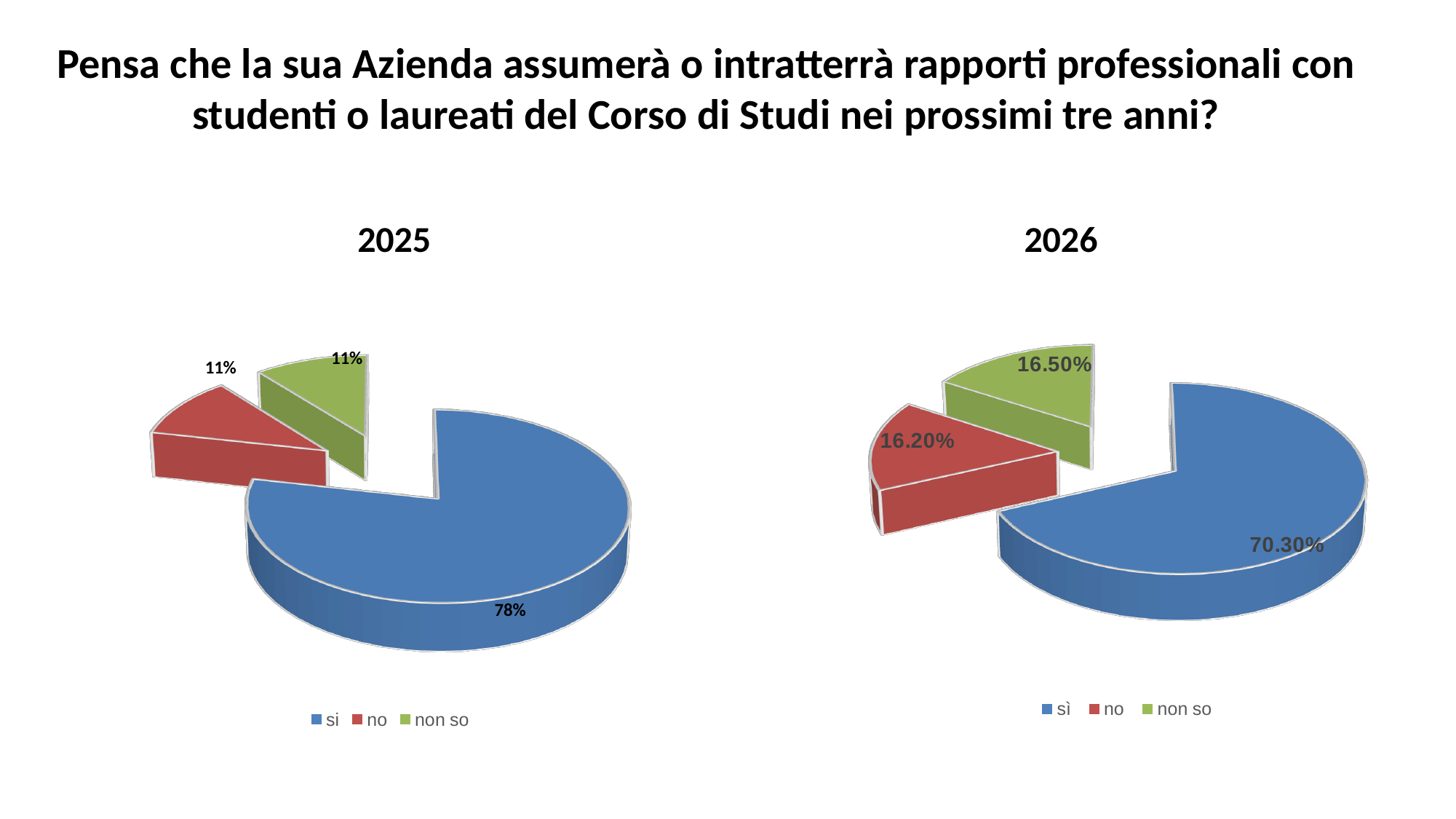
In the 2026 pie chart, which is larger, "no" or "non so"? non so In the 2026 pie chart, what percentage is shown for "no"? 16.20% In the 2026 pie chart, what is the difference between the "sì" and "no" percentages? 54.10% How many entries does the legend of the 2026 chart list? 3 In the 2025 pie chart, which category has the largest slice? si In the 2026 pie chart, what colour is the "sì" slice? Blue In the 2025 pie chart, what is the difference between the "si" and "no" percentages? 67% In the 2025 pie chart, what percentage is shown for "si"? 78% What type of chart is used for the 2025 data? Pie chart How many slices does the 2025 pie chart have? 3 In the 2026 pie chart, which category has the smallest slice? no In the 2026 pie chart, what percentage is shown for "non so"? 16.50%